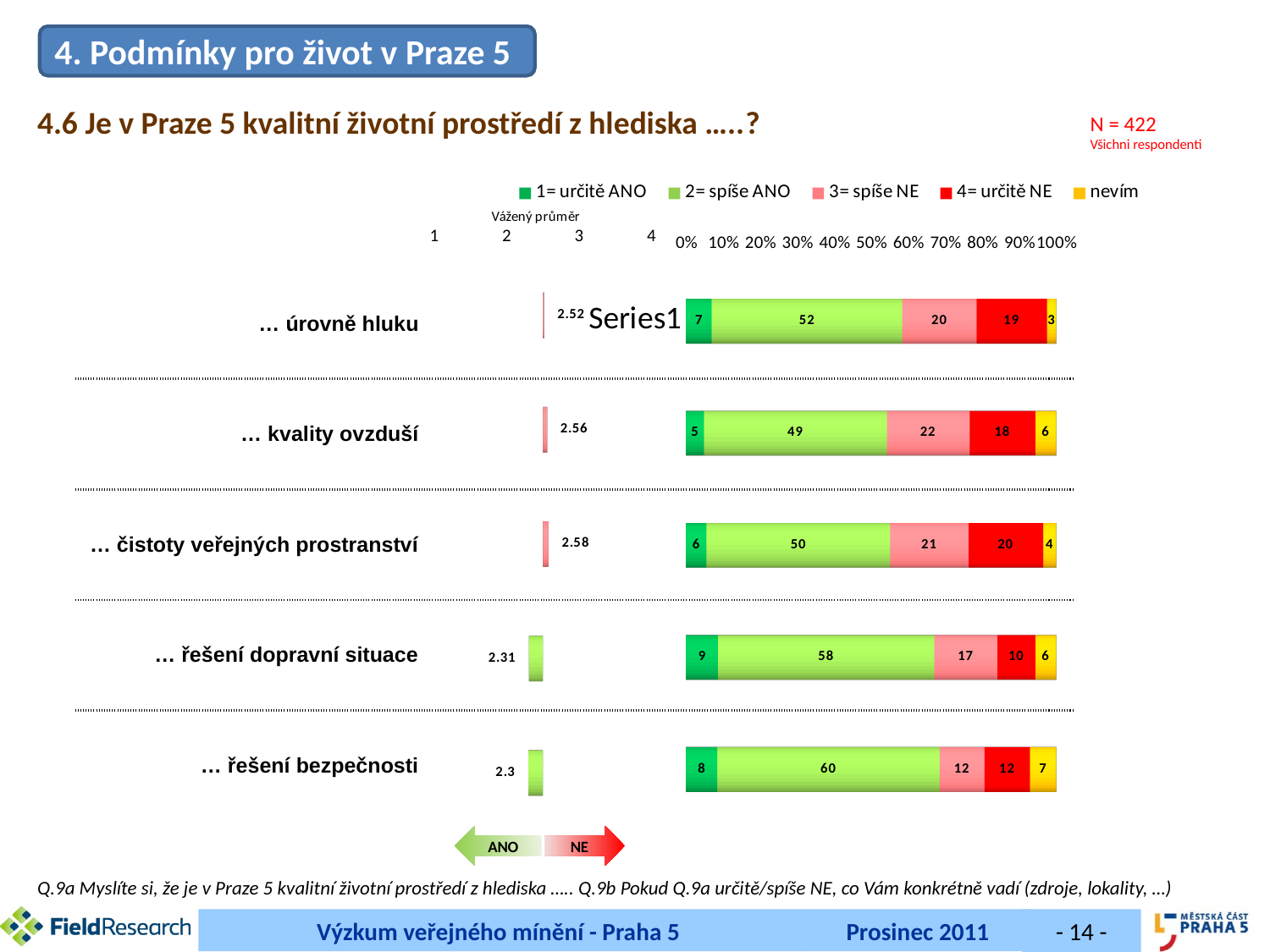
Which is larger: the '1= určitě ANO' value for '… řešení dopravní situace' or for '… kvality ovzduší'? … řešení dopravní situace What is the weighted average (Vážený průměr) shown for '… řešení dopravní situace'? 2.31 What type of chart is used to show the responses on this slide? stacked bar chart Which category has the highest weighted average (Vážený průměr)? … čistoty veřejných prostranství In the stacked bar chart, what is the value of '2= spíše ANO' for '… řešení bezpečnosti'? 60 In the stacked bar chart, what is the value of '3= spíše NE' for '… kvality ovzduší'? 22 Which category has the lowest '4= určitě NE' value in the stacked bar chart? … řešení dopravní situace How many categories (rows) are shown in the stacked bar chart? 5 Which category has the highest '2= spíše ANO' value in the stacked bar chart? … řešení bezpečnosti In the stacked bar chart, what is the value of '4= určitě NE' for '… čistoty veřejných prostranství'? 20 What is the difference between the '2= spíše ANO' values for '… řešení bezpečnosti' and '… kvality ovzduší'? 11 How many series does the legend of the stacked bar chart list? 5